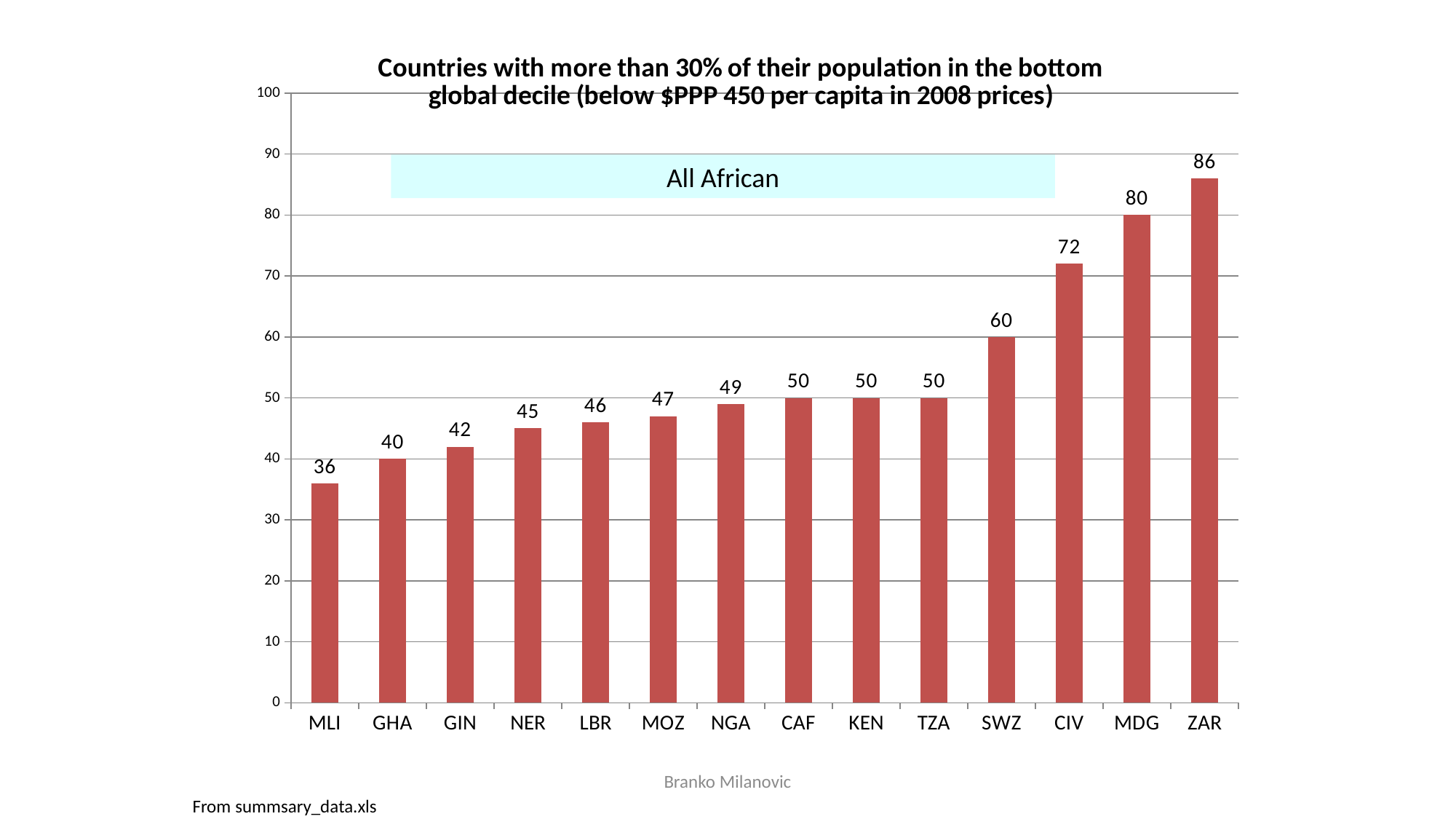
Do the values rise or fall from left to right along the x axis? rise What is the difference between the values for ZAR and MDG? 6 Which country has the highest value? ZAR Which country has the lowest value? MLI Is the value for GIN greater or less than 50? less What is the value for NGA? 49 What kind of chart is this? bar chart What is the difference between the values for SWZ and GHA? 20 What is the value for MLI? 36 What is the value for CIV? 72 How many countries are shown on the chart? 14 Which is larger, the value for NER or the value for MOZ? MOZ